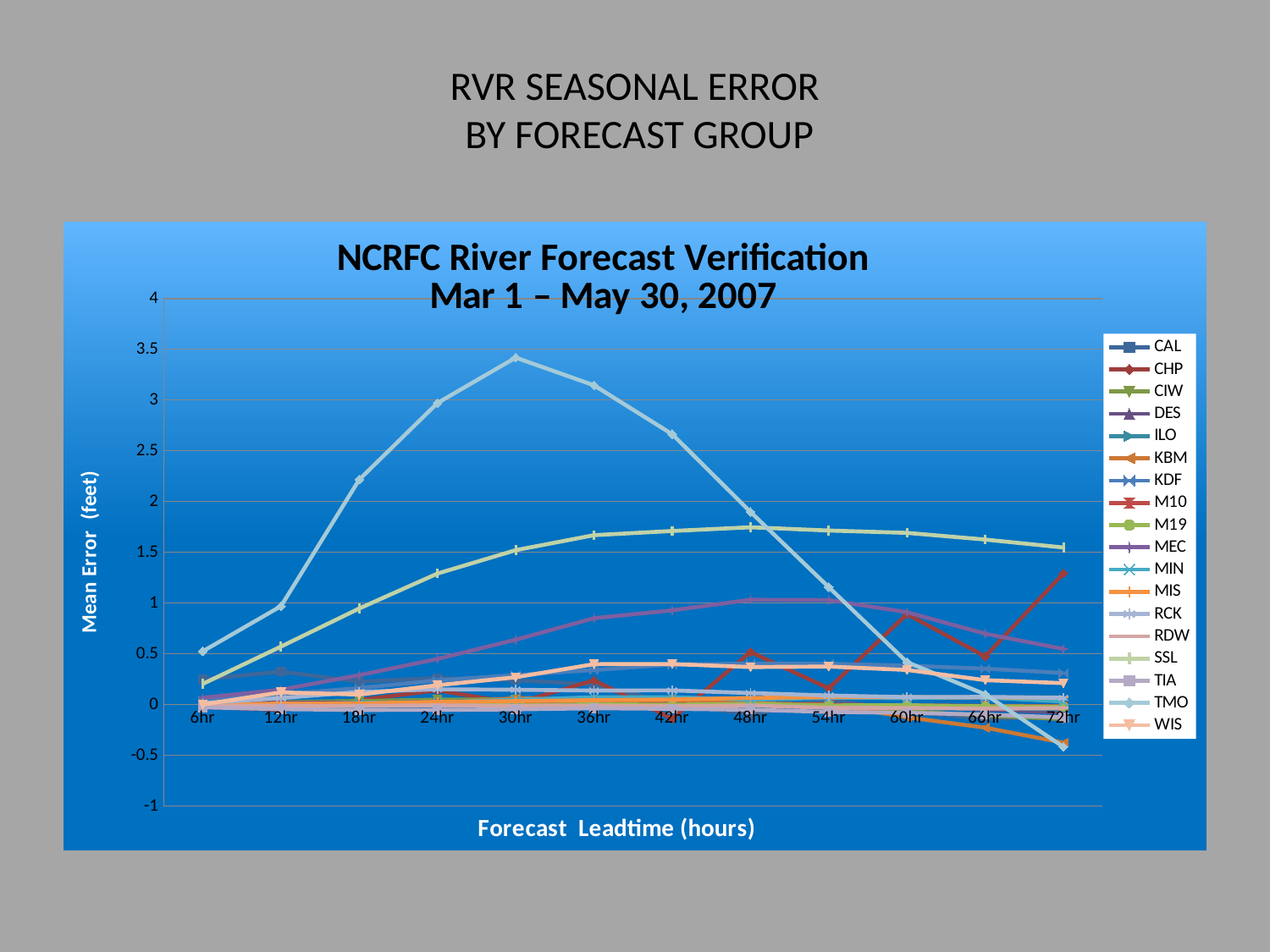
What is the title of the chart? NCRFC River Forecast Verification Mar 1 – May 30, 2007 Which series reaches the highest mean error on the chart? TMO Is the value for TMO at 72hr greater or less than 0? less What kind of chart is shown on the slide? line chart How many forecast leadtime points are plotted along the x axis? 12 How many series does the legend list? 18 Is the value for TMO at 18hr greater or less than 2? greater Is the value for TMO at 30hr greater or less than 3? greater Does the TMO series rise or fall from 30hr to 72hr? fall What is the label of the y axis? Mean Error (feet) Does the SSL series rise or fall from 6hr to 48hr? rise